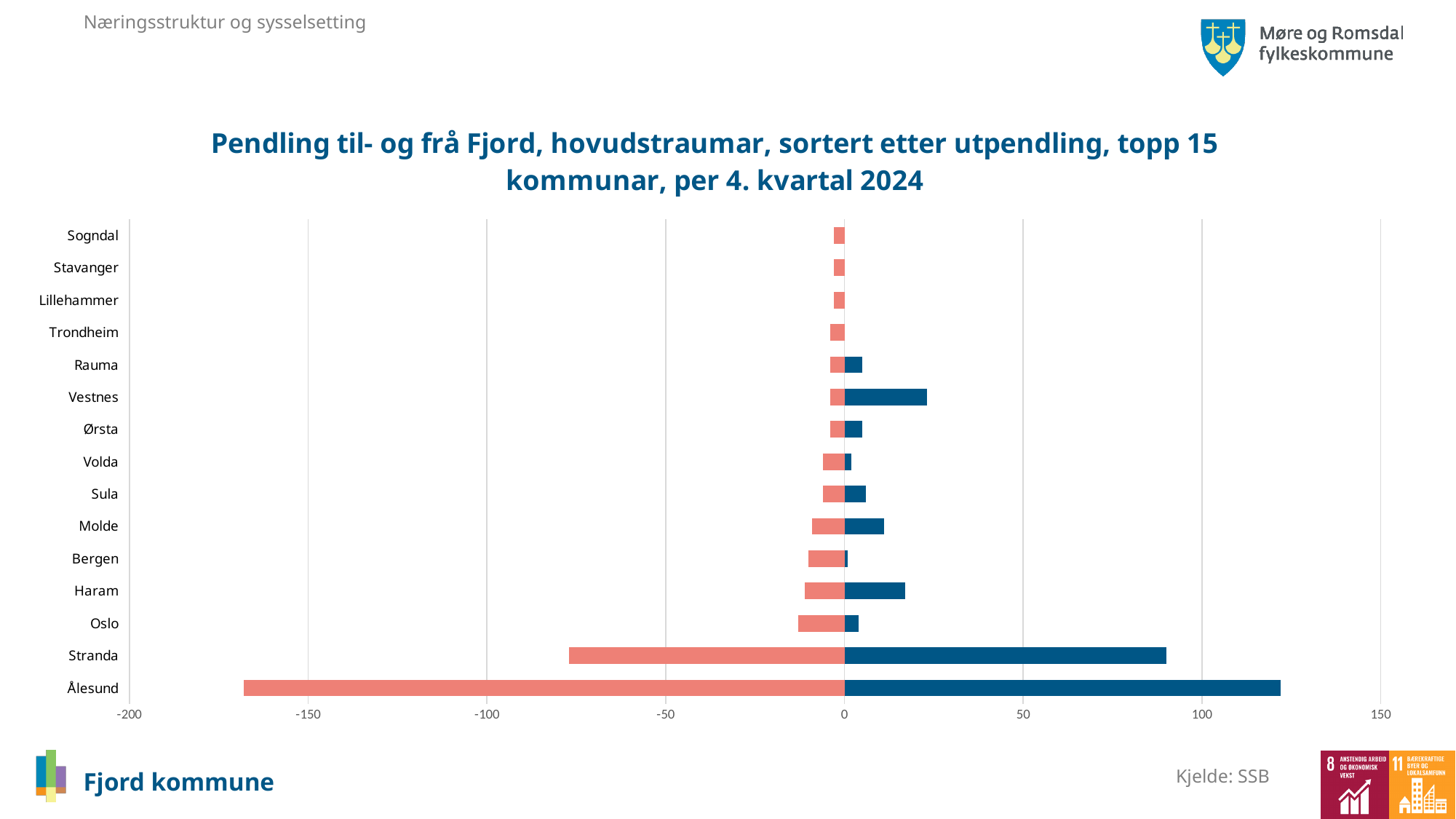
Is the blue bar value for Ålesund greater or less than 100? greater Is the red bar value for Ålesund greater or less than -150? less Is the blue bar value for Stranda greater or less than 100? less Which municipality has the longest red bar (outbound commuting from Fjord)? Ålesund Which municipality has the longest blue bar (inbound commuting to Fjord)? Ålesund Which has the longer red bar, Molde or Sogndal? Molde What is the source cited for the chart data? SSB Which has the longer blue bar, Stranda or Ålesund? Ålesund What kind of chart is shown on the slide? bar chart How many municipalities are listed on the vertical axis of the chart? 15 Which quarter and year does the chart title say the data is for? 4. kvartal 2024